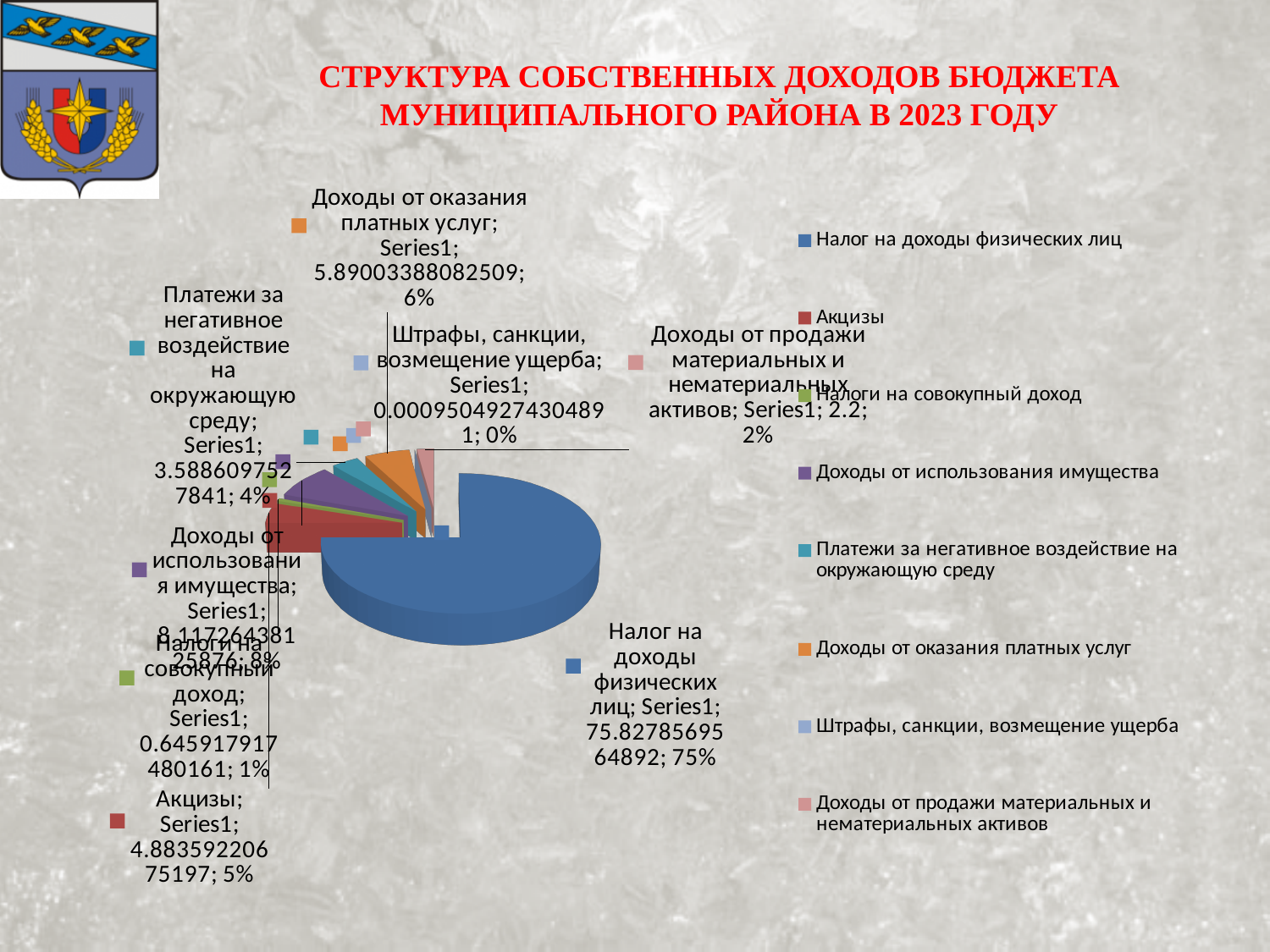
How many categories does the pie chart have? 8 Which category has the largest share of the pie chart? Налог на доходы физических лиц Which has a larger share: Акцизы or Доходы от оказания платных услуг? Доходы от оказания платных услуг What percentage share does Налог на доходы физических лиц have in the pie chart? 75% What is the title of the slide containing the chart? СТРУКТУРА СОБСТВЕННЫХ ДОХОДОВ БЮДЖЕТА МУНИЦИПАЛЬНОГО РАЙОНА В 2023 ГОДУ What percentage share does Платежи за негативное воздействие на окружающую среду have in the pie chart? 4% What percentage share does Доходы от использования имущества have in the pie chart? 8% What percentage share does Акцизы have in the pie chart? 5% What percentage share does Доходы от оказания платных услуг have in the pie chart? 6% Which category has the smallest share of the pie chart? Штрафы, санкции, возмещение ущерба What percentage share does Доходы от продажи материальных и нематериальных активов have in the pie chart? 2% What kind of chart is shown on the slide? pie chart